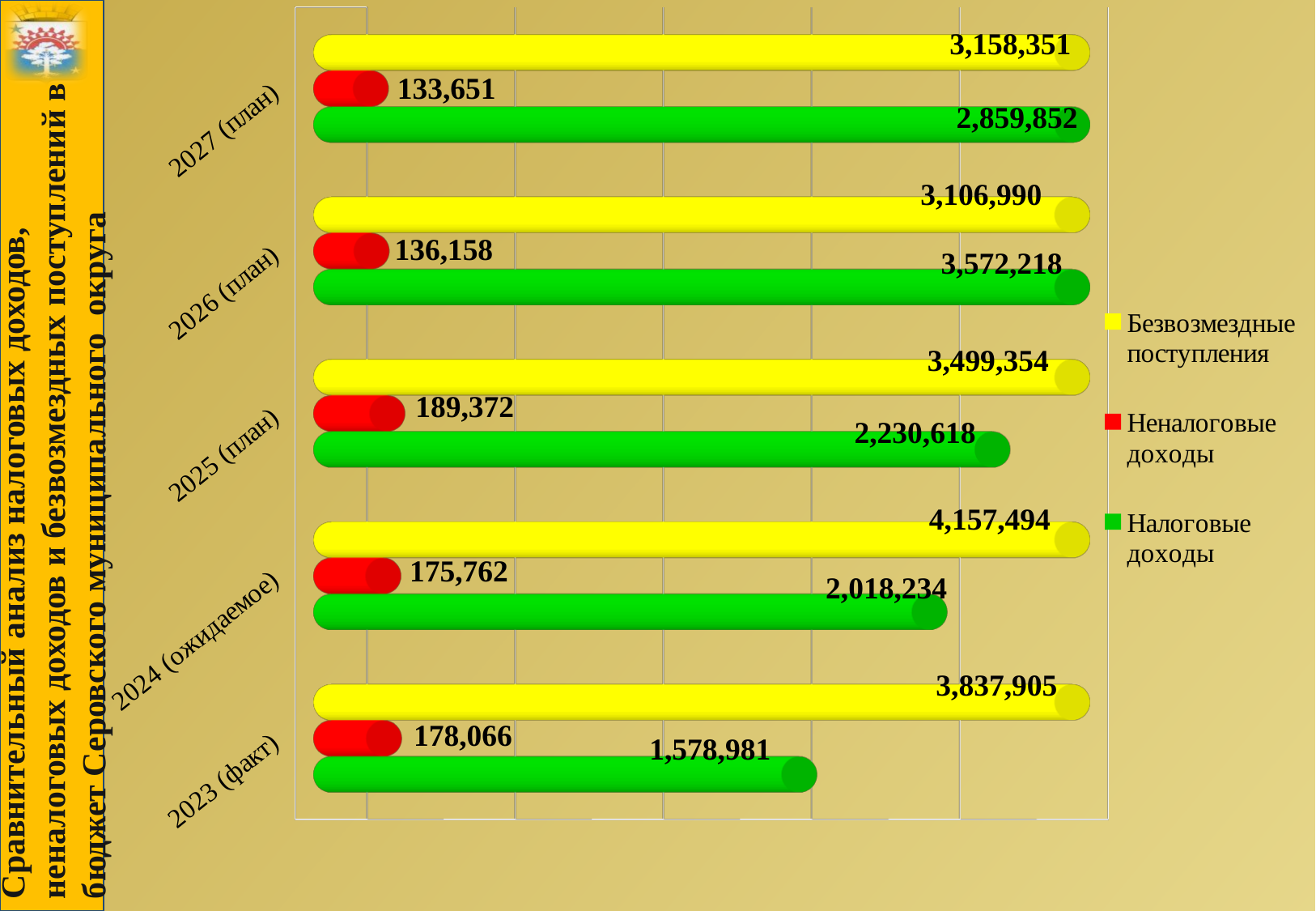
Do the values of Налоговые доходы rise or fall from 2023 (факт) to 2025 (план)? Rise What is the value of Налоговые доходы for 2023 (факт)? 1,578,981 In which year is Неналоговые доходы the lowest? 2027 (план) What is the value of Неналоговые доходы for 2026 (план)? 136,158 What is the difference between Налоговые доходы in 2024 (ожидаемое) and 2023 (факт)? 439,253 Which is larger for 2027 (план): Безвозмездные поступления or Налоговые доходы? Безвозмездные поступления What is the value of Безвозмездные поступления for 2024 (ожидаемое)? 4,157,494 How many series does the legend list? 3 In which year is Безвозмездные поступления the highest? 2024 (ожидаемое) In which year is Налоговые доходы the highest? 2026 (план) How many years (categories) are shown on the chart? 5 What kind of chart is shown on the slide? Bar chart